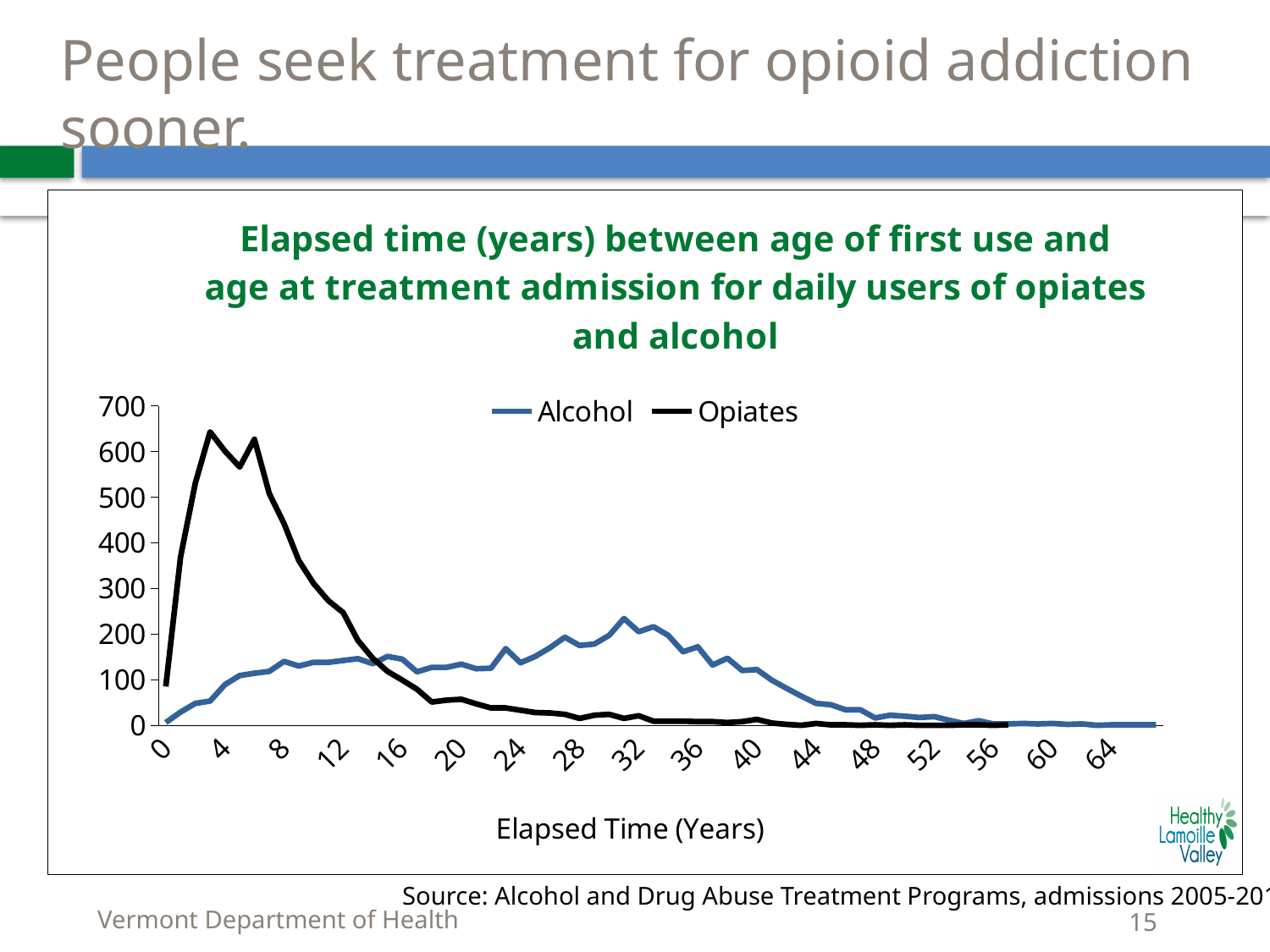
At an elapsed time of 32 years, which series has the larger value, Alcohol or Opiates? Alcohol Is the Alcohol value at 48 years greater or less than 100? less Is the Opiates value at 20 years greater or less than 100? less At an elapsed time of 8 years, which series has the larger value, Alcohol or Opiates? Opiates Which colour is used for the Alcohol series? Blue What kind of chart is shown on the slide? Line chart What is the label of the x axis? Elapsed Time (Years) Does the Opiates line rise or fall between 8 and 20 years of elapsed time? fall How many series does the legend list? 2 Which series reaches the higher peak value, Alcohol or Opiates? Opiates Is the Opiates value at 12 years greater or less than 200? greater